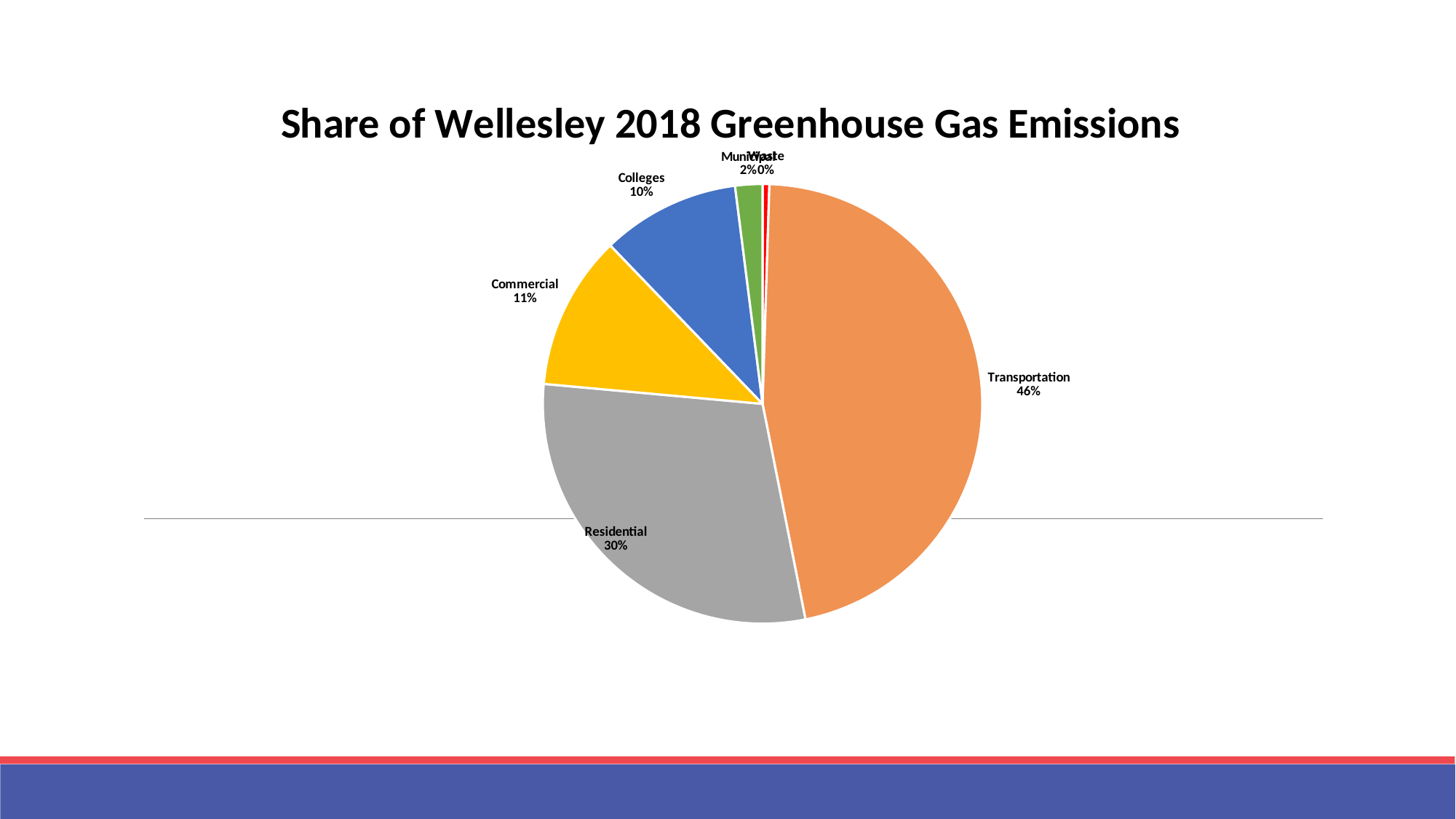
Which category has the smallest share of emissions? Waste Which category has the largest share of emissions? Transportation What is the difference in percentage points between the Transportation and Residential shares? 16 Which has a larger share, Commercial or Colleges? Commercial What share of emissions does Colleges account for? 10% What share of emissions does Residential account for? 30% What share of emissions does Transportation account for? 46% What colour is the Transportation slice? orange How many categories are shown in the pie chart? 6 What type of chart is shown on the slide? pie chart What is the title of the chart? Share of Wellesley 2018 Greenhouse Gas Emissions